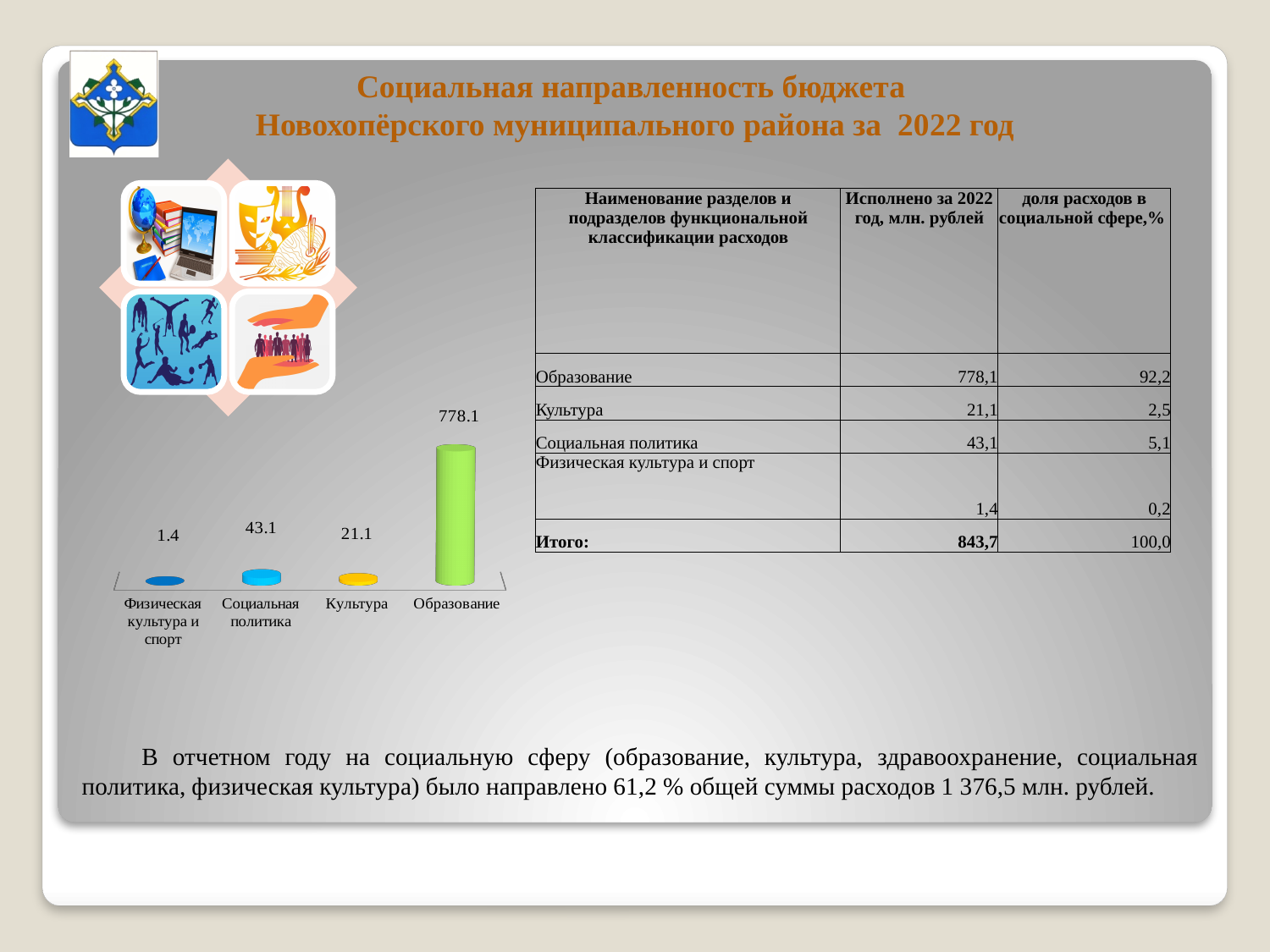
What is the value shown for Образование in the bar chart? 778.1 What is the difference between the values for Образование and Социальная политика in the bar chart? 735.0 Which category has the highest value in the bar chart? Образование What is the value shown for Физическая культура и спорт in the bar chart? 1.4 Which is larger in the bar chart: the value for Культура or the value for Социальная политика? Социальная политика Which category has the lowest value in the bar chart? Физическая культура и спорт What is the value shown for Социальная политика in the bar chart? 43.1 What is the difference between the values for Социальная политика and Культура in the bar chart? 22.0 What type of chart is shown on the slide? Bar chart What is the value shown for Культура in the bar chart? 21.1 What colour is the bar for Образование in the chart? Green How many categories are shown in the bar chart? 4